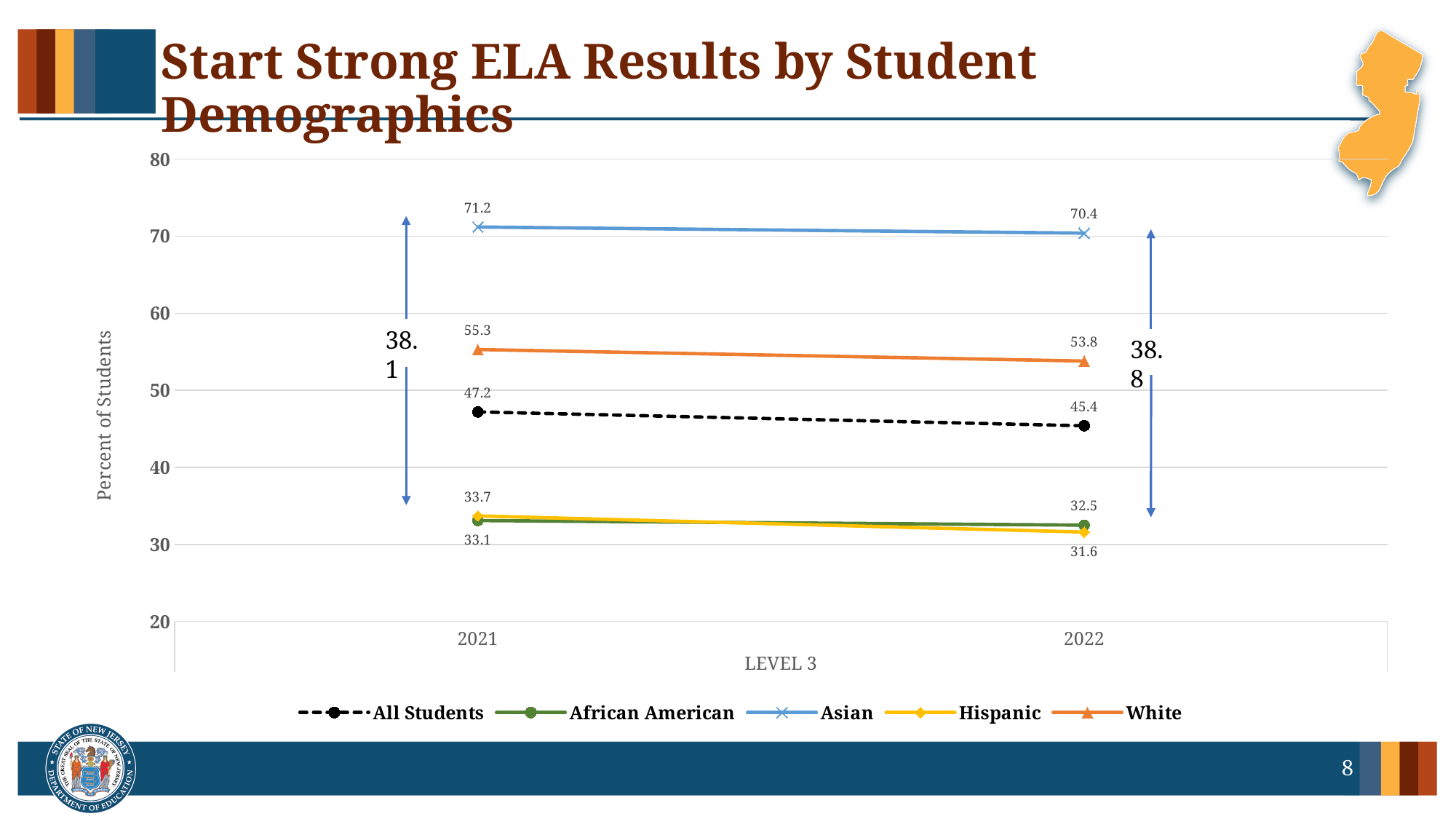
What is the label on the vertical axis? Percent of Students How many series does the legend list? 5 What kind of chart is shown on the slide? line chart What is the value for White students in 2022? 53.8 What is the value for Hispanic students in 2022? 31.6 Which student group has the lowest value in 2022? Hispanic Which is larger in 2021, the value for White students or for All Students? White What is the value for All Students in 2021? 47.2 What is the difference between the Asian values for 2021 and 2022? 0.8 Which student group has the highest value in 2022? Asian Does the All Students line rise or fall from 2021 to 2022? fall What is the value for Asian students in 2021? 71.2